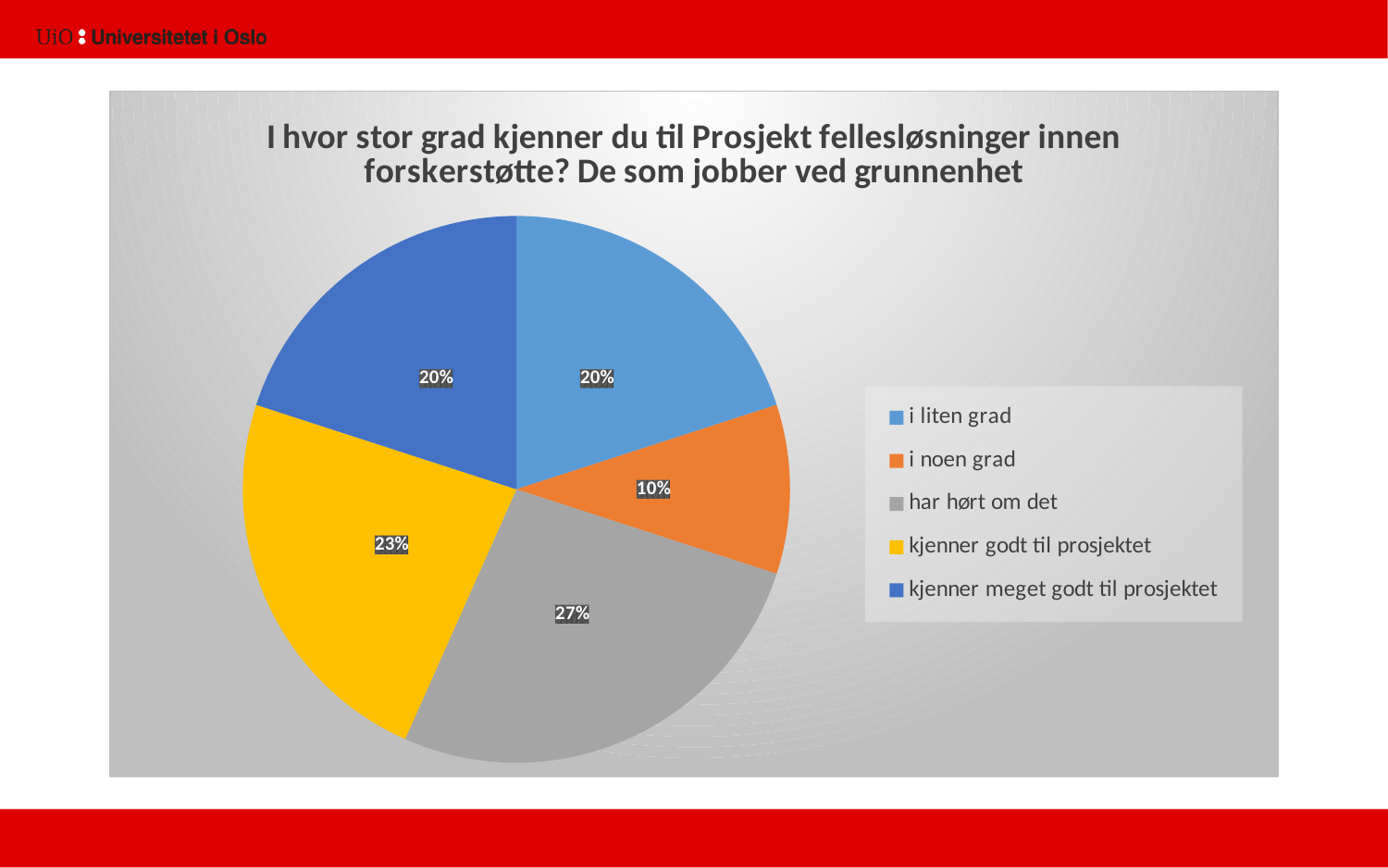
What share of the pie is 'i liten grad'? 20% Which category has the smallest slice of the pie? i noen grad Which category is shown in yellow in the legend? kjenner godt til prosjektet What is the combined share of 'i liten grad' and 'kjenner meget godt til prosjektet'? 40% What kind of chart is shown on the slide? pie chart What share of the pie is 'kjenner godt til prosjektet'? 23% Which is larger, the slice for 'kjenner godt til prosjektet' or the slice for 'i noen grad'? kjenner godt til prosjektet What share of the pie is 'har hørt om det'? 27% How many categories does the pie chart have? 5 What is the difference in percentage points between 'har hørt om det' and 'i noen grad'? 17 Which category has the largest slice of the pie? har hørt om det